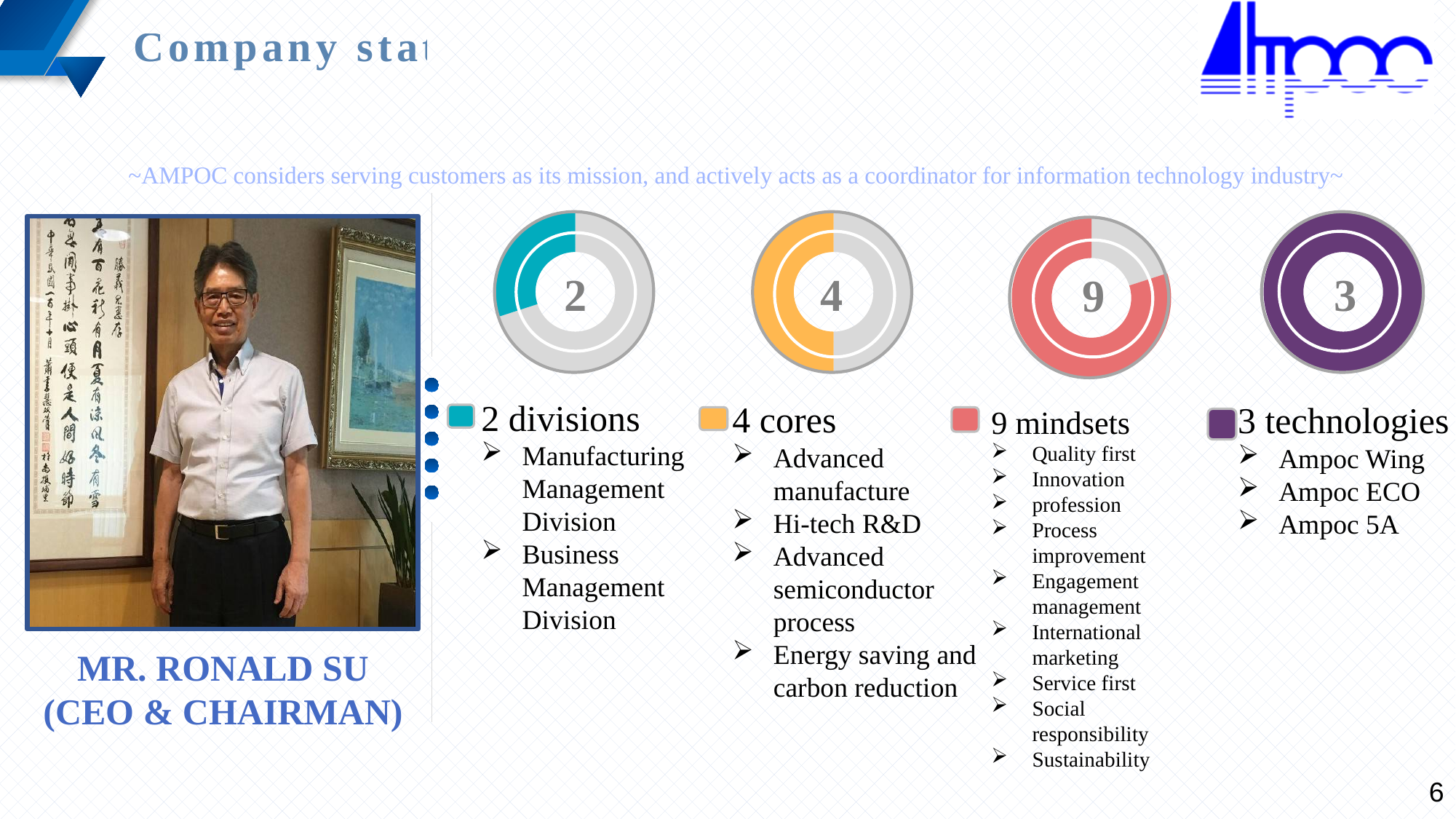
What kind of chart is used to display the numbers 2, 4, 9 and 3 on the slide? Doughnut chart What number is shown in the centre of the red doughnut chart labelled "9 mindsets"? 9 What number is shown in the centre of the purple doughnut chart labelled "3 technologies"? 3 What number is shown in the centre of the teal doughnut chart labelled "2 divisions"? 2 What is the difference between the number in the "9 mindsets" chart and the number in the "2 divisions" chart? 7 What number is shown in the centre of the orange doughnut chart labelled "4 cores"? 4 What colour is the doughnut chart for "4 cores"? Orange Which is larger, the number in the "4 cores" chart or the number in the "3 technologies" chart? 4 cores How many doughnut charts are shown on the slide? 4 Which of the four doughnut charts shows the lowest number in its centre? 2 divisions What colour is the doughnut chart for "3 technologies"? Purple Which of the four doughnut charts shows the highest number in its centre? 9 mindsets